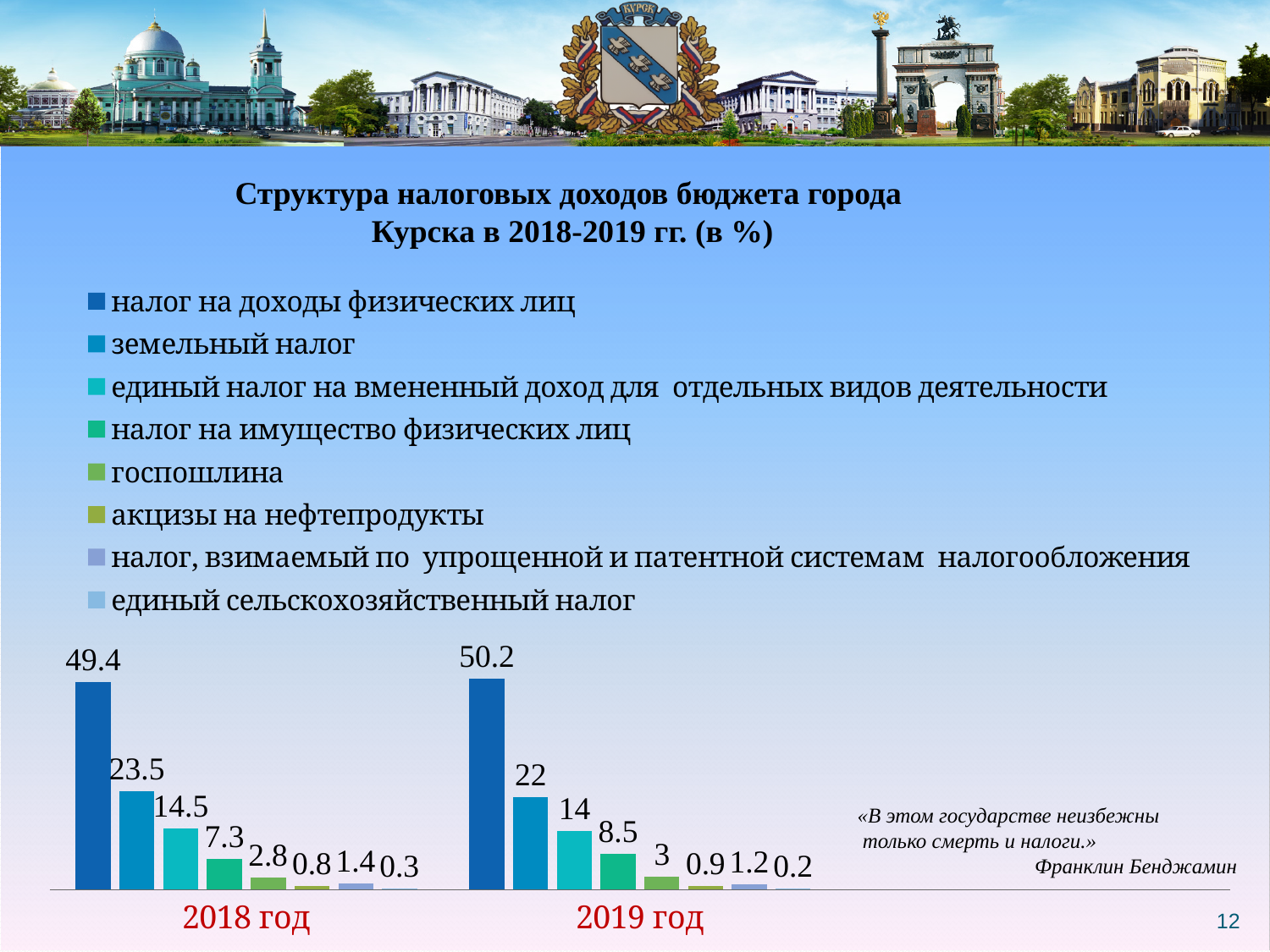
What is the value for земельный налог in 2019 год? 22 What type of chart is shown on the slide? bar chart What is the value for налог на доходы физических лиц in 2019 год? 50.2 Which series has the lowest value in 2018 год? единый сельскохозяйственный налог What is the value for единый сельскохозяйственный налог in 2019 год? 0.2 What is the value for налог на имущество физических лиц in 2018 год? 7.3 Which series has the highest value in 2019 год? налог на доходы физических лиц What is the value for налог на доходы физических лиц in 2018 год? 49.4 How many year categories are shown on the x axis? 2 What is the difference between the values for земельный налог in 2018 год and 2019 год? 1.5 How many series does the legend list? 8 Which is larger: госпошлина in 2018 год or госпошлина in 2019 год? 2019 год